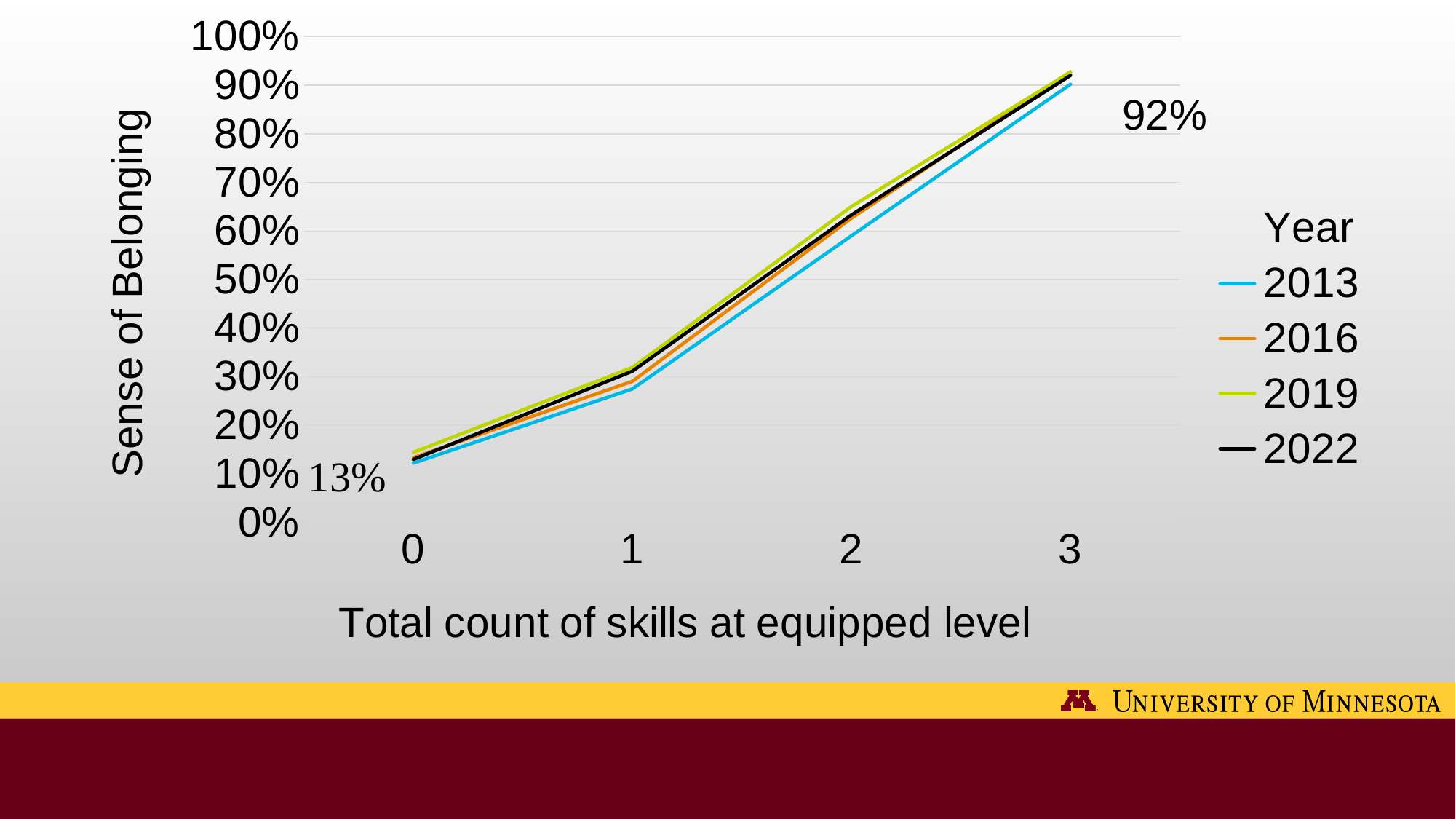
How many points are plotted along the x axis for each series? 4 Is the value for 2013 at 1 skill greater or less than 30%? less What data label is printed at the 0 skills point? 13% What data label is printed at the 3 skills point? 92% Do the values rise or fall as the total count of skills at equipped level increases from 0 to 3? rise At 2 skills, which is larger, the value for 2013 or the value for 2019? 2019 What kind of chart is shown on the slide? line chart How many series does the legend list? 4 Which year has the lowest value at 2 skills? 2013 Is the value for 2019 at 2 skills greater or less than 60%? greater What is the title of the y axis? Sense of Belonging Is the value for 2016 at 0 skills greater or less than 20%? less